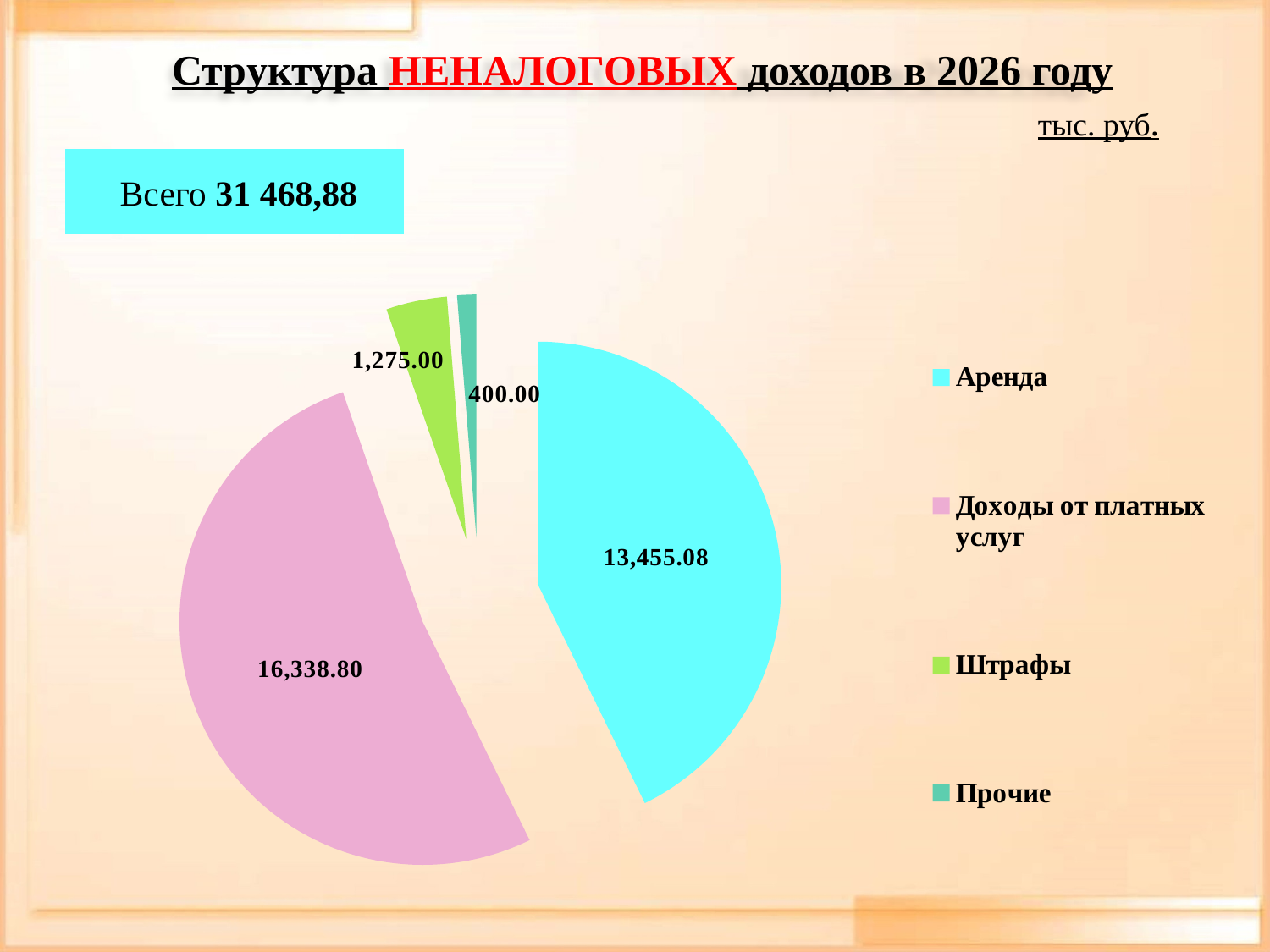
What is the value for Аренда? 13,455.08 Which category has the largest slice of the pie? Доходы от платных услуг What is the value for Прочие? 400.00 What is the difference between the values for Доходы от платных услуг and Аренда? 2,883.72 Which is larger, the value for Штрафы or the value for Прочие? Штрафы What is the value for Штрафы? 1,275.00 What is the total shown on the slide for all non-tax revenues (Всего)? 31 468,88 How many categories does the pie chart have? 4 What type of chart is shown on the slide? pie chart Which category has the smallest slice of the pie? Прочие What colour is the slice for Аренда? cyan What is the value for Доходы от платных услуг? 16,338.80